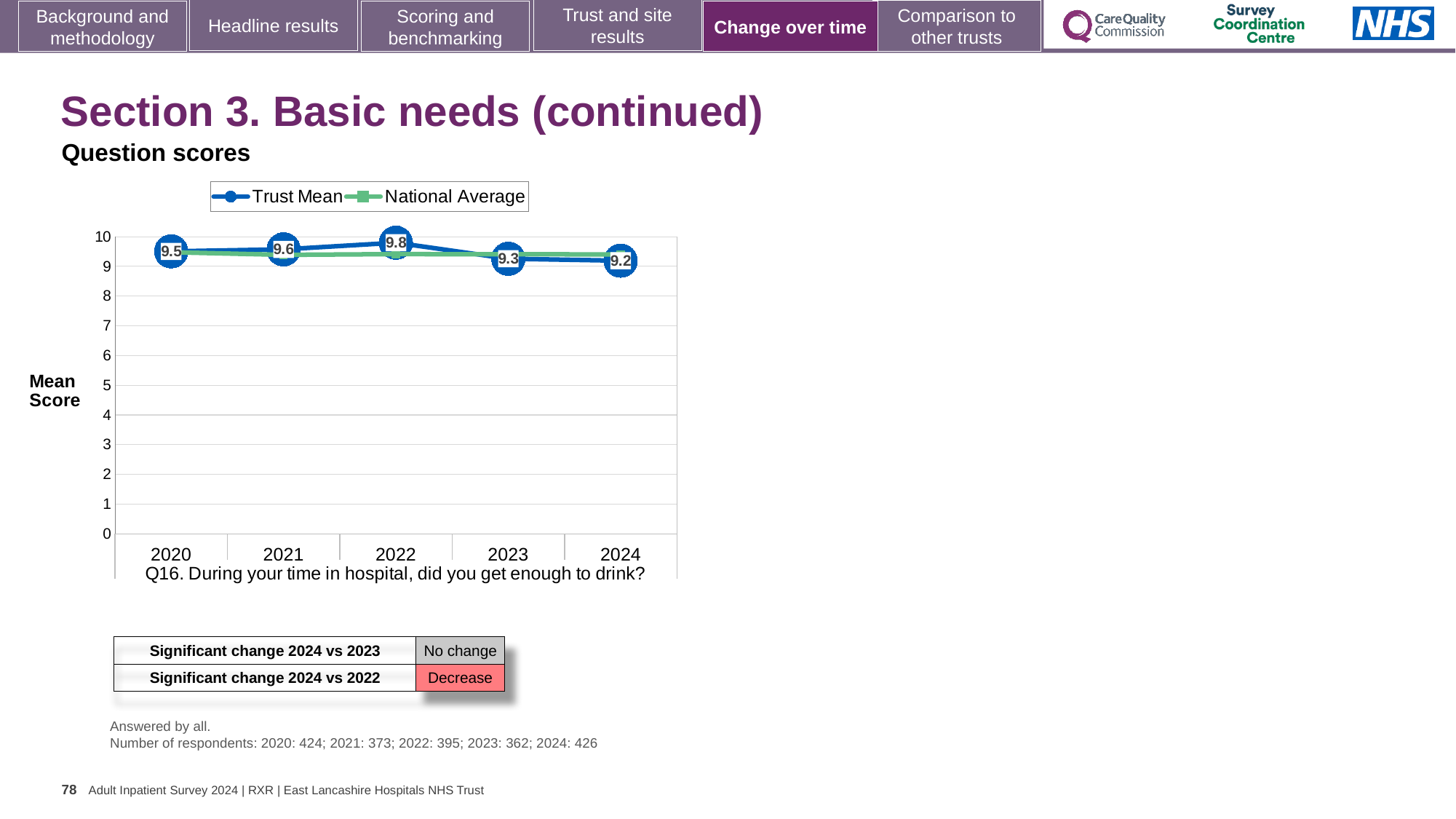
How many series does the legend list? 2 Does the Trust Mean rise or fall from 2022 to 2024? Fall In which year is the Trust Mean lowest? 2024 What is the Trust Mean score for 2024? 9.2 What is the Trust Mean score for 2020? 9.5 In which year is the Trust Mean highest? 2022 How many years are plotted on the x axis? 5 Which year has the larger Trust Mean, 2021 or 2023? 2021 What is the Trust Mean score for 2022? 9.8 Is the National Average value for 2020 greater or less than 9? greater What is the difference between the Trust Mean in 2022 and in 2024? 0.6 What kind of chart is shown on the slide? Line chart